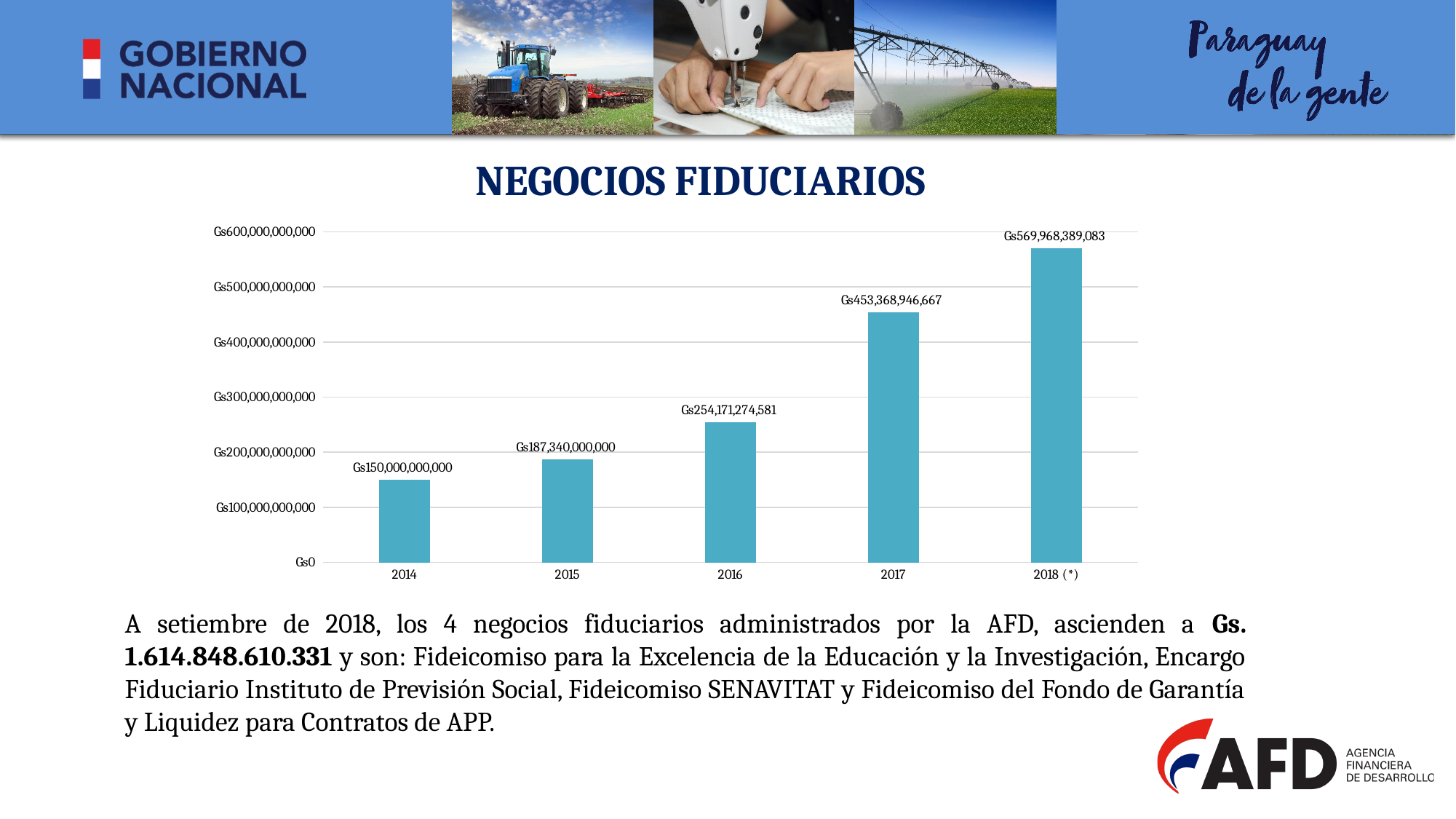
What is the value for 2014? Gs150,000,000,000 Do the values rise or fall from 2014 to 2018 (*)? Rise How many years are shown on the x axis? 5 Which year has the lowest value? 2014 Which year has the highest value? 2018 (*) What is the value for 2015? Gs187,340,000,000 What is the value for 2017? Gs453,368,946,667 What is the difference between the values for 2015 and 2014? Gs37,340,000,000 What is the value for 2018 (*)? Gs569,968,389,083 What is the value for 2016? Gs254,171,274,581 What type of chart is shown on the slide? Bar chart What is the difference between the values for 2018 (*) and 2017? Gs116,599,442,416